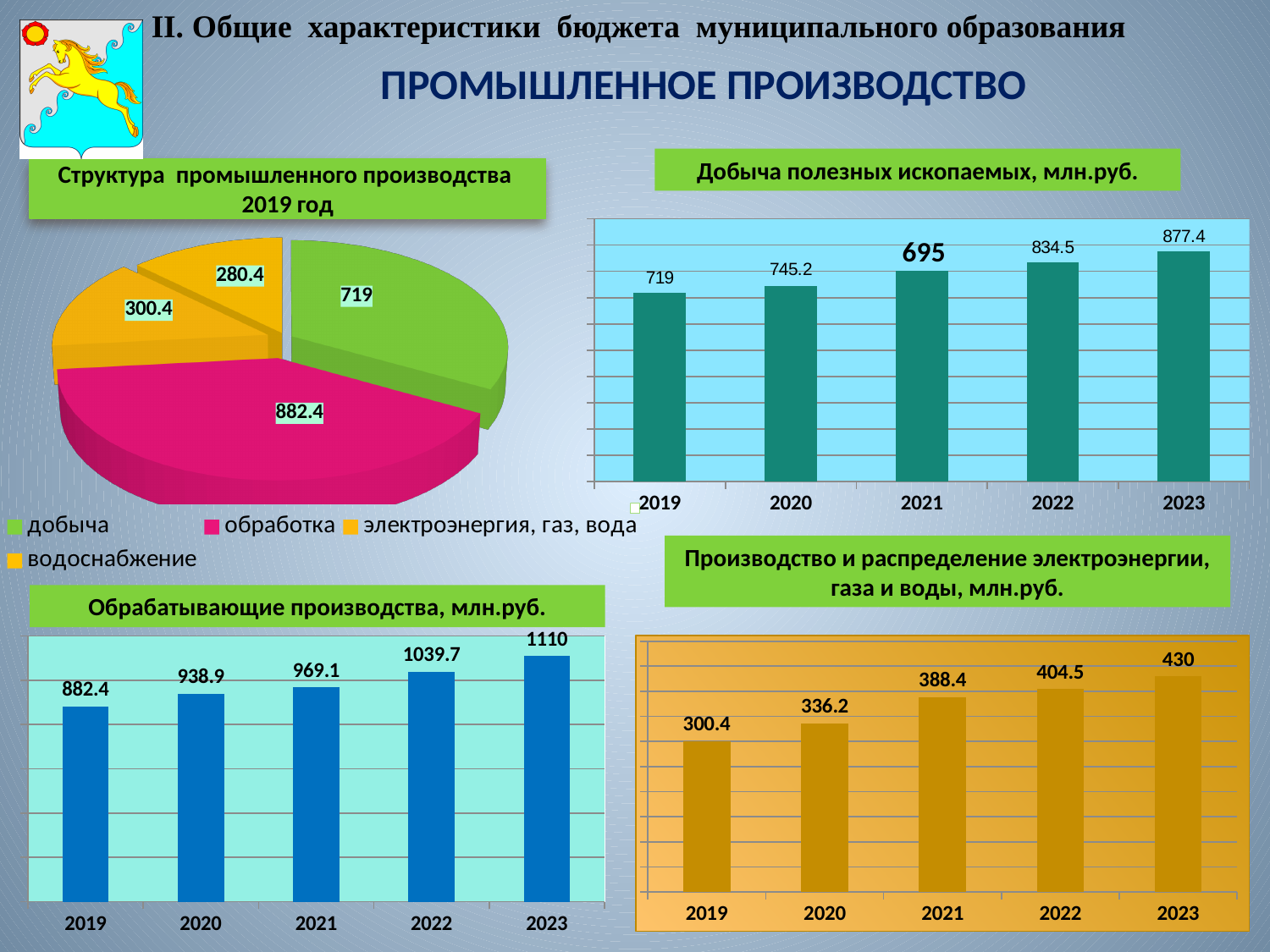
In the chart 'Обрабатывающие производства, млн.руб.', do the values rise or fall from 2019 to 2023? rise In the chart 'Добыча полезных ископаемых, млн.руб.', which year has the highest value? 2023 In the pie chart 'Структура промышленного производства 2019 год', what is the value of the 'обработка' slice? 882.4 In the chart 'Обрабатывающие производства, млн.руб.', which year has the lowest value? 2019 In the chart 'Обрабатывающие производства, млн.руб.', what is the value for 2021? 969.1 In the chart 'Производство и распределение электроэнергии, газа и воды, млн.руб.', which is larger: the value for 2022 or the value for 2021? 2022 In the chart 'Производство и распределение электроэнергии, газа и воды, млн.руб.', what is the value for 2020? 336.2 How many entries does the legend of the pie chart 'Структура промышленного производства 2019 год' list? 4 In the chart 'Добыча полезных ископаемых, млн.руб.', what is the value for 2023? 877.4 In the pie chart 'Структура промышленного производства 2019 год', which category has the largest slice? обработка In the chart 'Добыча полезных ископаемых, млн.руб.', what is the difference between the values for 2023 and 2022? 42.9 How many years are shown on the x axis of the chart 'Производство и распределение электроэнергии, газа и воды, млн.руб.'? 5